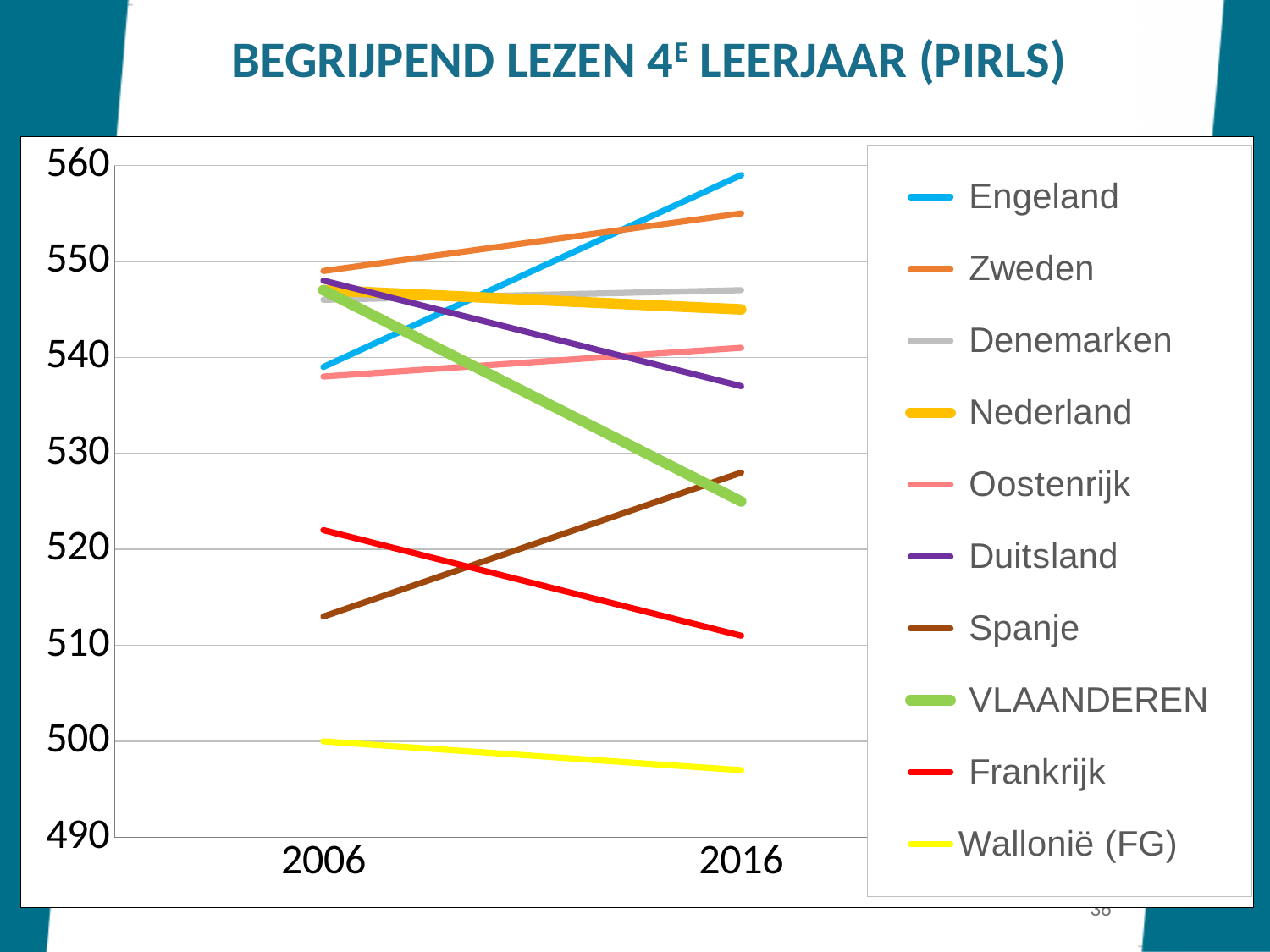
Does the value for Engeland rise or fall from 2006 to 2016? rise What is the title of the slide? BEGRIJPEND LEZEN 4E LEERJAAR (PIRLS) Is the value for Frankrijk in 2006 greater or less than 520? greater Does the value for VLAANDEREN rise or fall from 2006 to 2016? fall How many years are shown on the x axis? 2 Which series has the lowest value in 2016? Wallonië (FG) How many series does the legend list? 10 Does the value for Spanje rise or fall from 2006 to 2016? rise What kind of chart is shown on the slide? line chart Is the value for VLAANDEREN in 2016 greater or less than 530? less Which is larger in 2016, the value for Zweden or the value for Duitsland? Zweden Which series has the highest value in 2016? Engeland